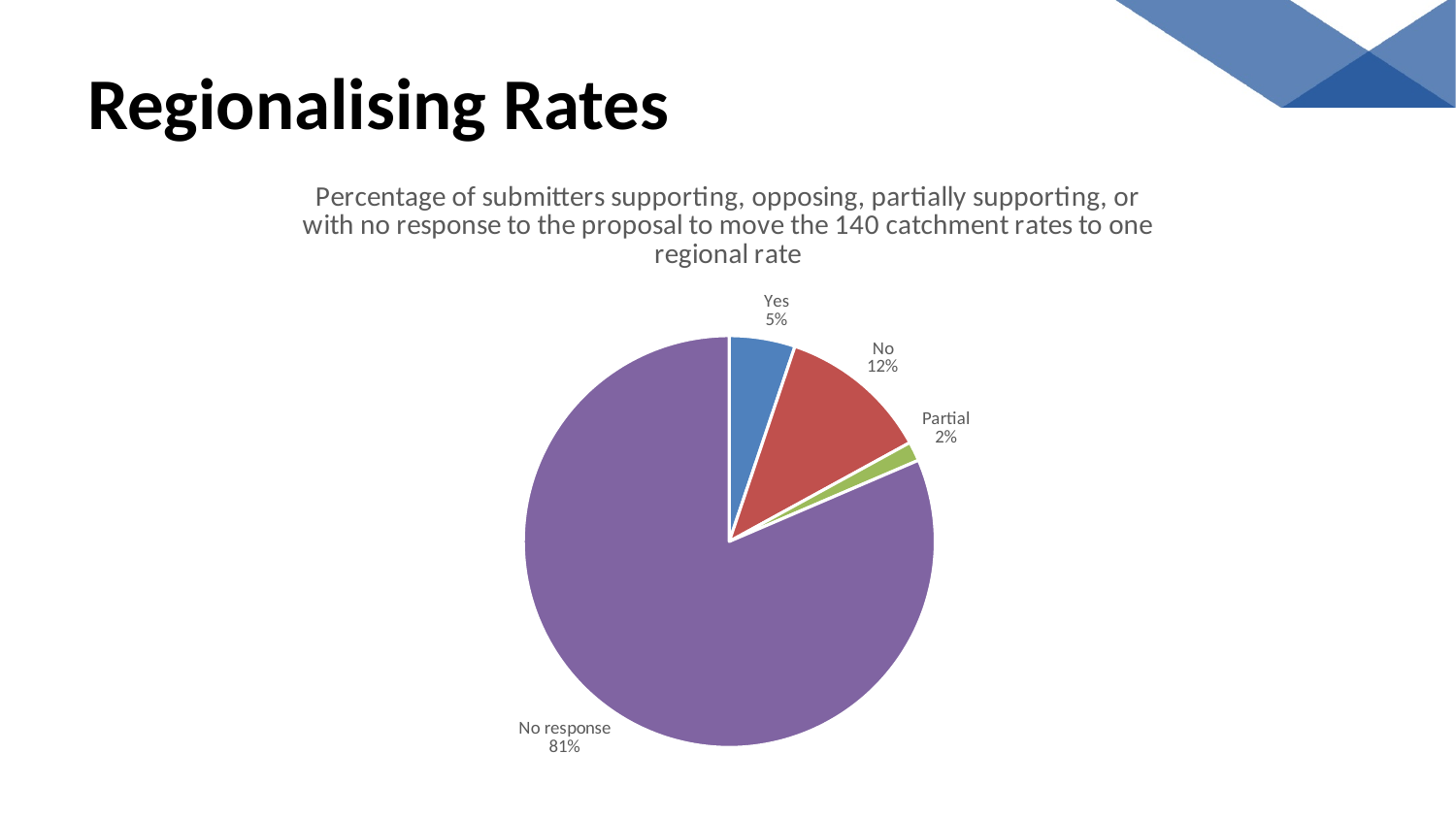
Which is larger, the share for Yes or the share for No? No How many slices does the pie chart have? 4 What is the combined percentage of Yes, No and Partial responses? 19% Which category has the smallest share of the pie? Partial Which category has the largest share of the pie? No response What percentage of submitters answered Yes? 5% What colour is the No response slice? purple What percentage of submitters partially supported the proposal? 2% What percentage of submitters answered No? 12% What percentage of submitters gave no response to the proposal? 81% What is the difference in percentage points between No and Yes? 7 What type of chart is shown on the slide? pie chart